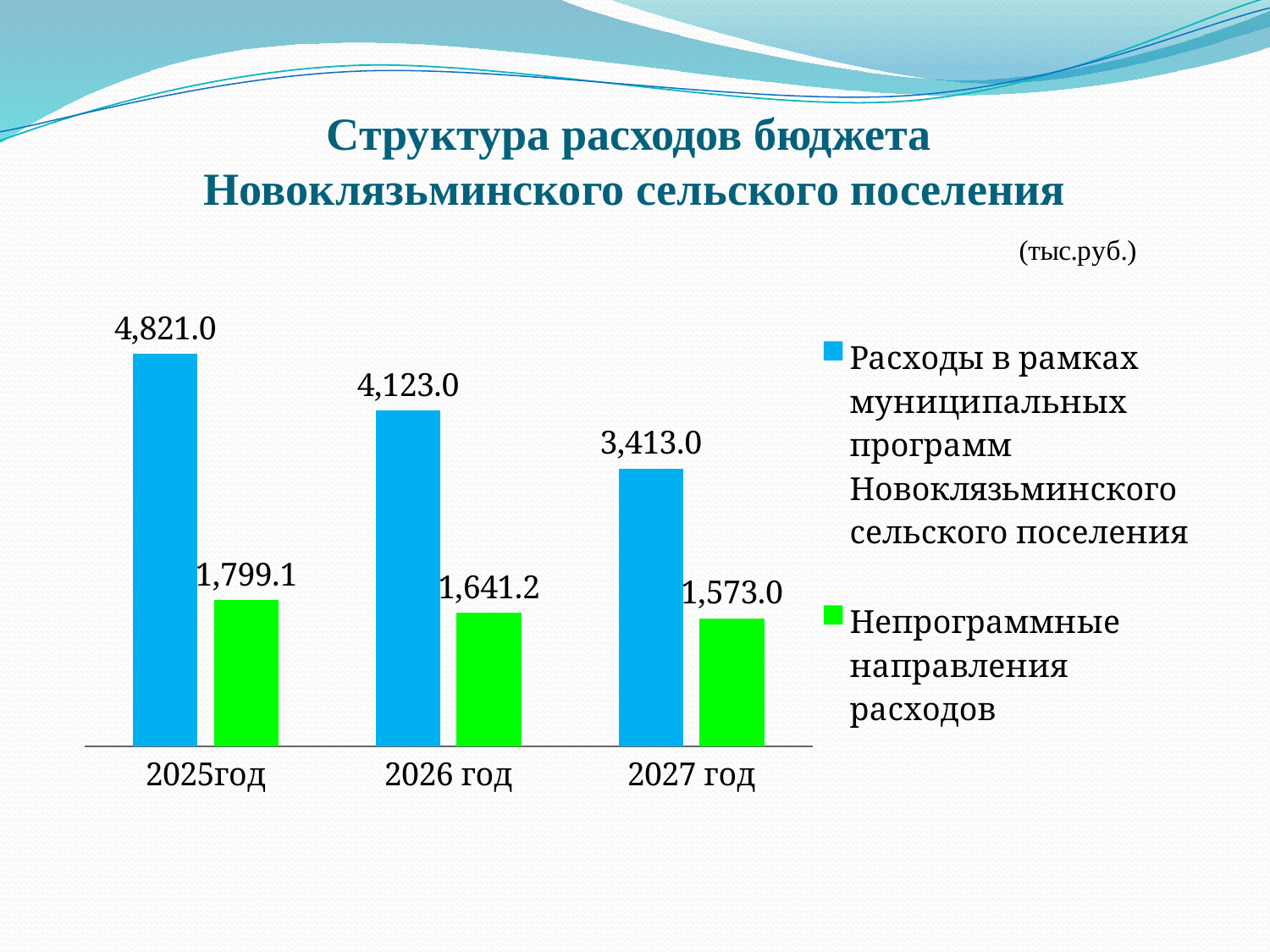
In which year is the value for 'Непрограммные направления расходов' lowest? 2027 год What is the value for 'Непрограммные направления расходов' in 2027 год? 1,573.0 Which is larger in 2026 год: 'Расходы в рамках муниципальных программ Новоклязьминского сельского поселения' or 'Непрограммные направления расходов'? Расходы в рамках муниципальных программ Новоклязьминского сельского поселения In which year is the value for 'Расходы в рамках муниципальных программ Новоклязьминского сельского поселения' highest? 2025год What is the difference between the two series' values in 2025 год? 3,021.9 What is the value for 'Расходы в рамках муниципальных программ Новоклязьминского сельского поселения' in 2025 год? 4,821.0 By how much does the value for 'Расходы в рамках муниципальных программ Новоклязьминского сельского поселения' fall from 2026 год to 2027 год? 710.0 What is the value for 'Расходы в рамках муниципальных программ Новоклязьминского сельского поселения' in 2027 год? 3,413.0 How many series does the legend list? 2 What is the value for 'Непрограммные направления расходов' in 2026 год? 1,641.2 Do the values for 'Непрограммные направления расходов' rise or fall from 2025 год to 2027 год? fall How many years are shown on the x axis of the chart? 3